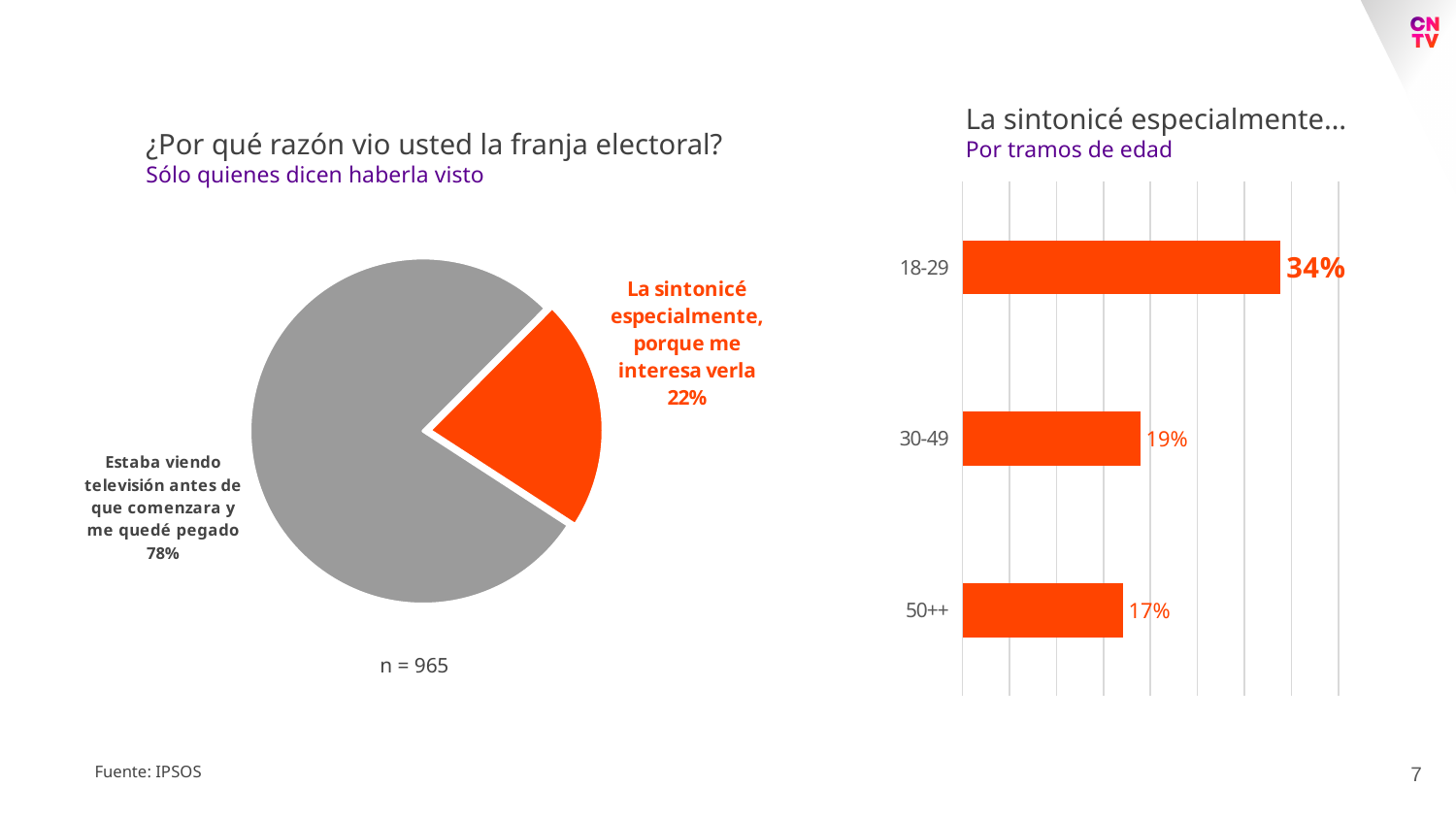
In the pie chart on the left, what percentage corresponds to 'La sintonicé especialmente, porque me interesa verla'? 22% In the bar chart 'La sintonicé especialmente... Por tramos de edad', which age group has the lowest value? 50++ In the pie chart on the left, which slice is the largest? Estaba viendo televisión antes de que comenzara y me quedé pegado In the pie chart on the left, how many slices are there? 2 In the bar chart 'La sintonicé especialmente... Por tramos de edad', what is the value for the 50++ age group? 17% In the pie chart on the left, what percentage corresponds to 'Estaba viendo televisión antes de que comenzara y me quedé pegado'? 78% In the bar chart 'La sintonicé especialmente... Por tramos de edad', what is the value for the 18-29 age group? 34% In the bar chart 'La sintonicé especialmente... Por tramos de edad', what is the difference between the 18-29 and 30-49 groups? 15 percentage points What kind of chart is on the left side of the slide? Pie chart What kind of chart is on the right side of the slide? Bar chart In the pie chart on the left, what is the difference between the two slices? 56 percentage points In the bar chart 'La sintonicé especialmente... Por tramos de edad', how many age groups are shown? 3